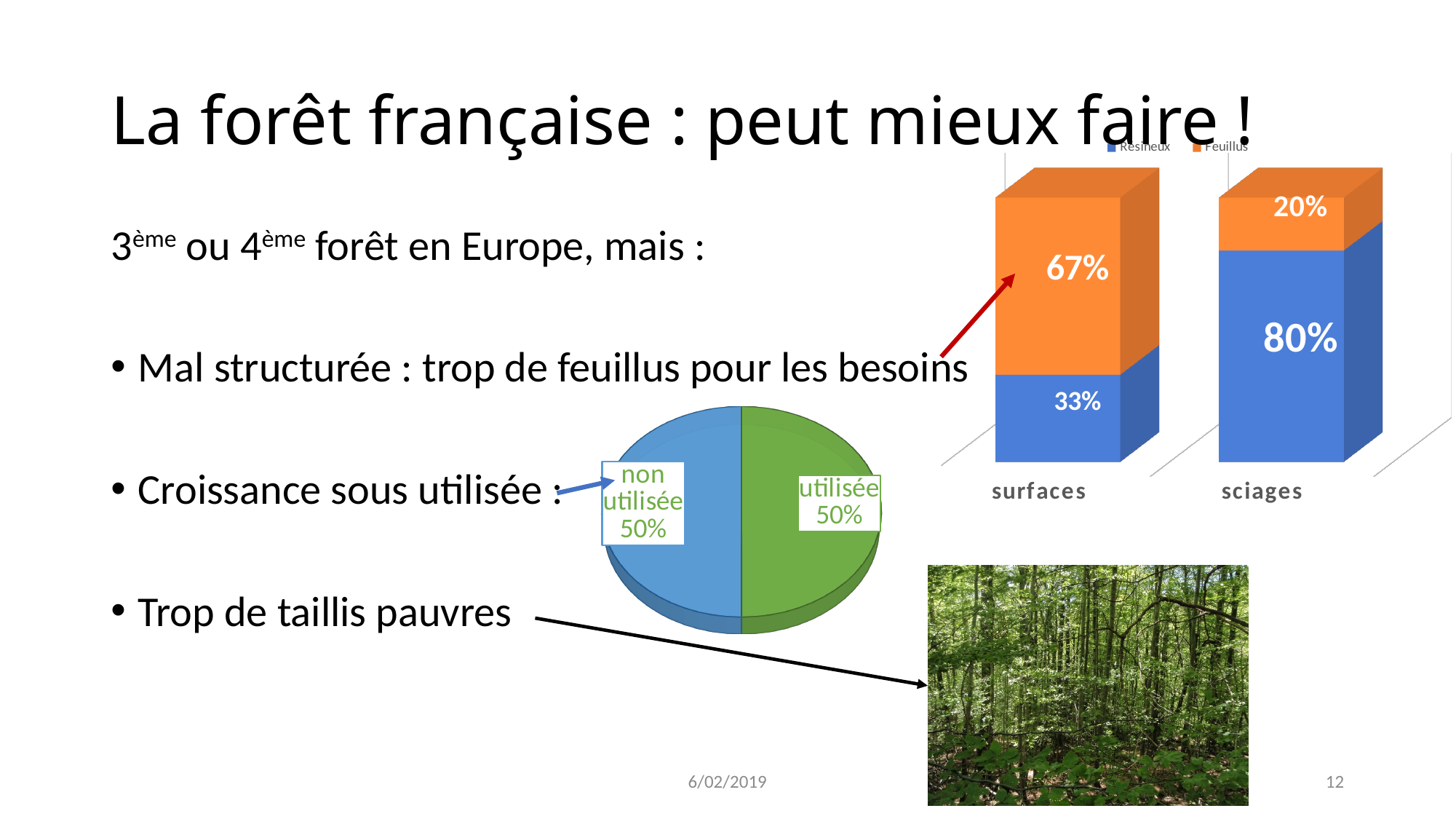
In the pie chart in the middle of the slide, what share does the 'utilisée' slice have? 50% In the pie chart in the middle of the slide, what colour is the 'non utilisée' slice? blue In the stacked bar chart on the right, how many categories are shown on the x axis? 2 In the stacked bar chart on the right, which is larger: the Résineux value for 'surfaces' or the Résineux value for 'sciages'? sciages In the stacked bar chart on the right, what is the value for Résineux in the 'sciages' bar? 80% In the stacked bar chart on the right, how many series does the legend list? 2 What kind of chart is the chart on the right with the 'surfaces' and 'sciages' categories? stacked bar chart In the stacked bar chart on the right, what is the value for Feuillus in the 'surfaces' bar? 67% In the stacked bar chart on the right, what is the difference between the Feuillus value for 'surfaces' and the Feuillus value for 'sciages'? 47% In the stacked bar chart on the right, what is the value for Feuillus in the 'sciages' bar? 20% In the stacked bar chart on the right, what is the value for Résineux in the 'surfaces' bar? 33% In the pie chart in the middle of the slide, how many slices are there? 2